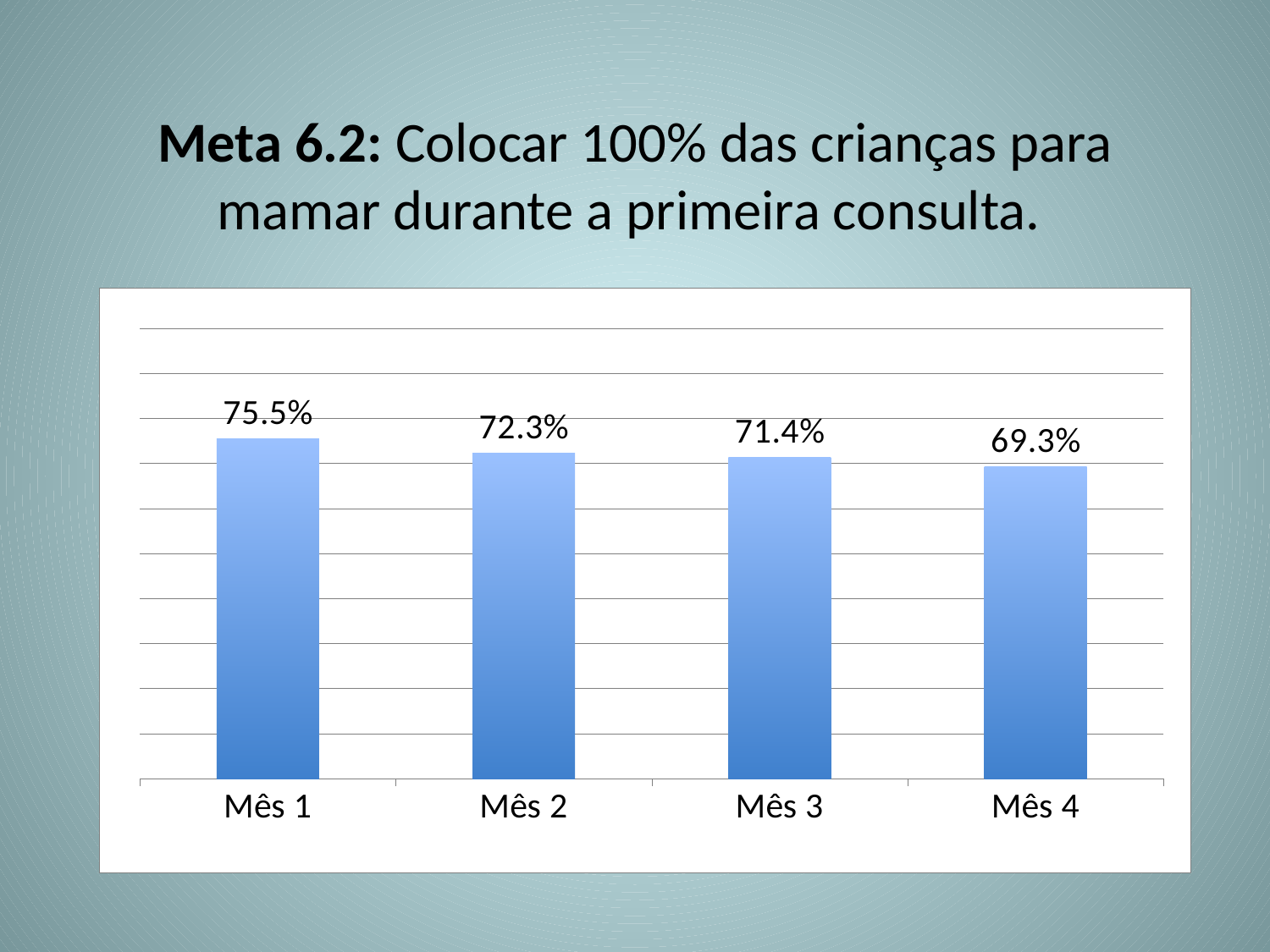
Which is larger, the value for Mês 2 or the value for Mês 4? Mês 2 How many months are shown on the x axis? 4 What is the difference between the values for Mês 2 and Mês 3? 0.9% What is the difference between the values for Mês 1 and Mês 4? 6.2% What is the value for Mês 3? 71.4% What is the value for Mês 1? 75.5% Do the values rise or fall from Mês 1 to Mês 4? Fall Which month has the lowest value? Mês 4 What is the value for Mês 4? 69.3% What kind of chart is shown on the slide? Bar chart Which month has the highest value? Mês 1 What is the value for Mês 2? 72.3%